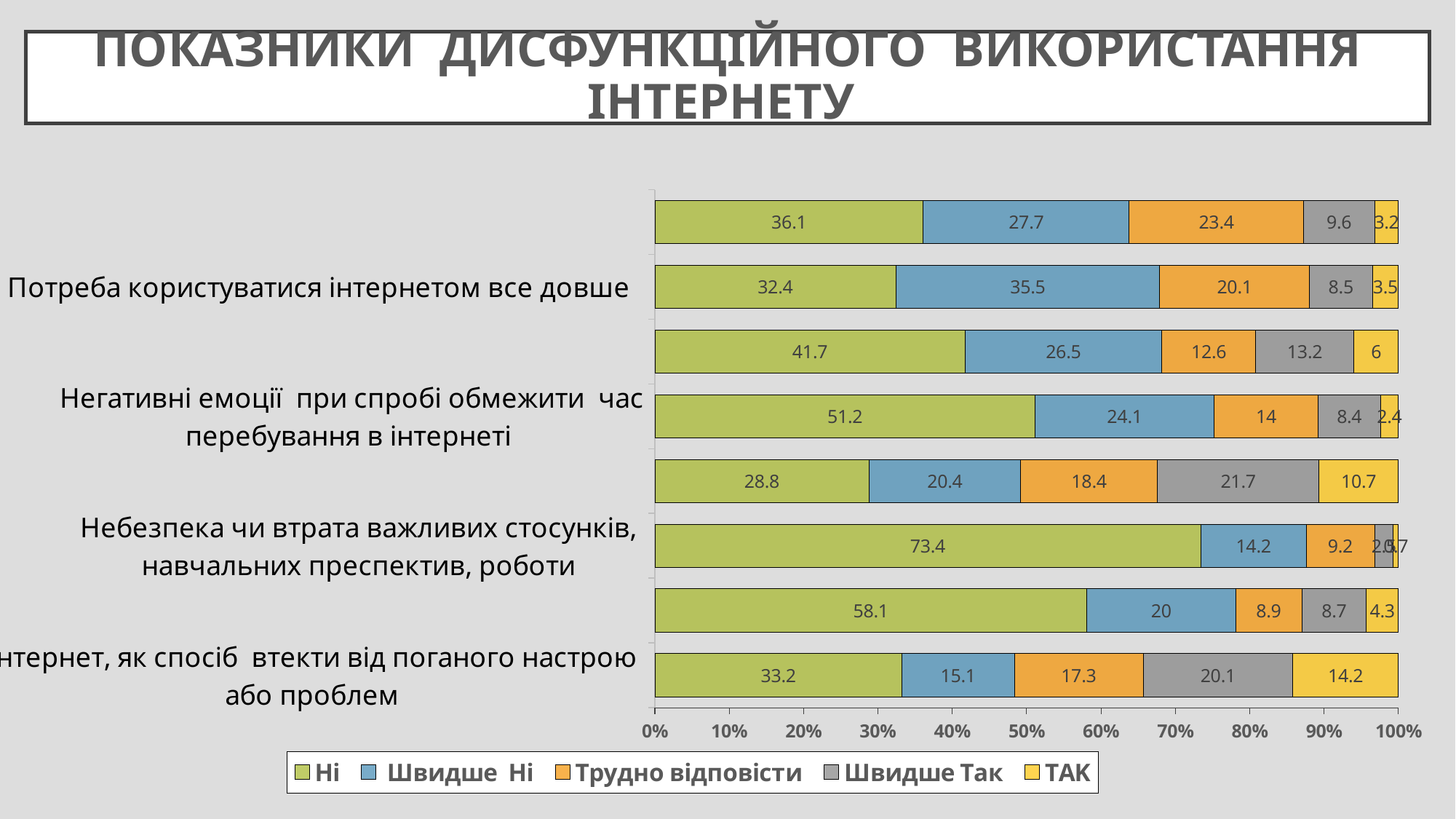
What is the value of the "Швидше Так" segment for "Інтернет, як спосіб втекти від поганого настрою або проблем"? 20.1 Which series has the smallest segment for "Негативні емоції при спробі обмежити час перебування в інтернеті"? ТАК What kind of chart is shown on the slide? Stacked bar chart Which has a larger "Ні" value: "Небезпека чи втрата важливих стосунків, навчальних преспектив, роботи" or "Негативні емоції при спробі обмежити час перебування в інтернеті"? Небезпека чи втрата важливих стосунків, навчальних преспектив, роботи What colour represents the "Ні" series in the legend? Green What is the value of the "Швидше Ні" segment for "Потреба користуватися інтернетом все довше"? 35.5 What is the value of the "ТАК" segment for "Інтернет, як спосіб втекти від поганого настрою або проблем"? 14.2 What is the value of the "Ні" segment for "Негативні емоції при спробі обмежити час перебування в інтернеті"? 51.2 What is the value of the "Ні" segment for "Потреба користуватися інтернетом все довше"? 32.4 What is the value of the "Трудно відповісти" segment for "Небезпека чи втрата важливих стосунків, навчальних преспектив, роботи"? 9.2 For "Негативні емоції при спробі обмежити час перебування в інтернеті", what is the difference between the "Ні" and "Швидше Ні" values? 27.1 How many series does the legend list? 5